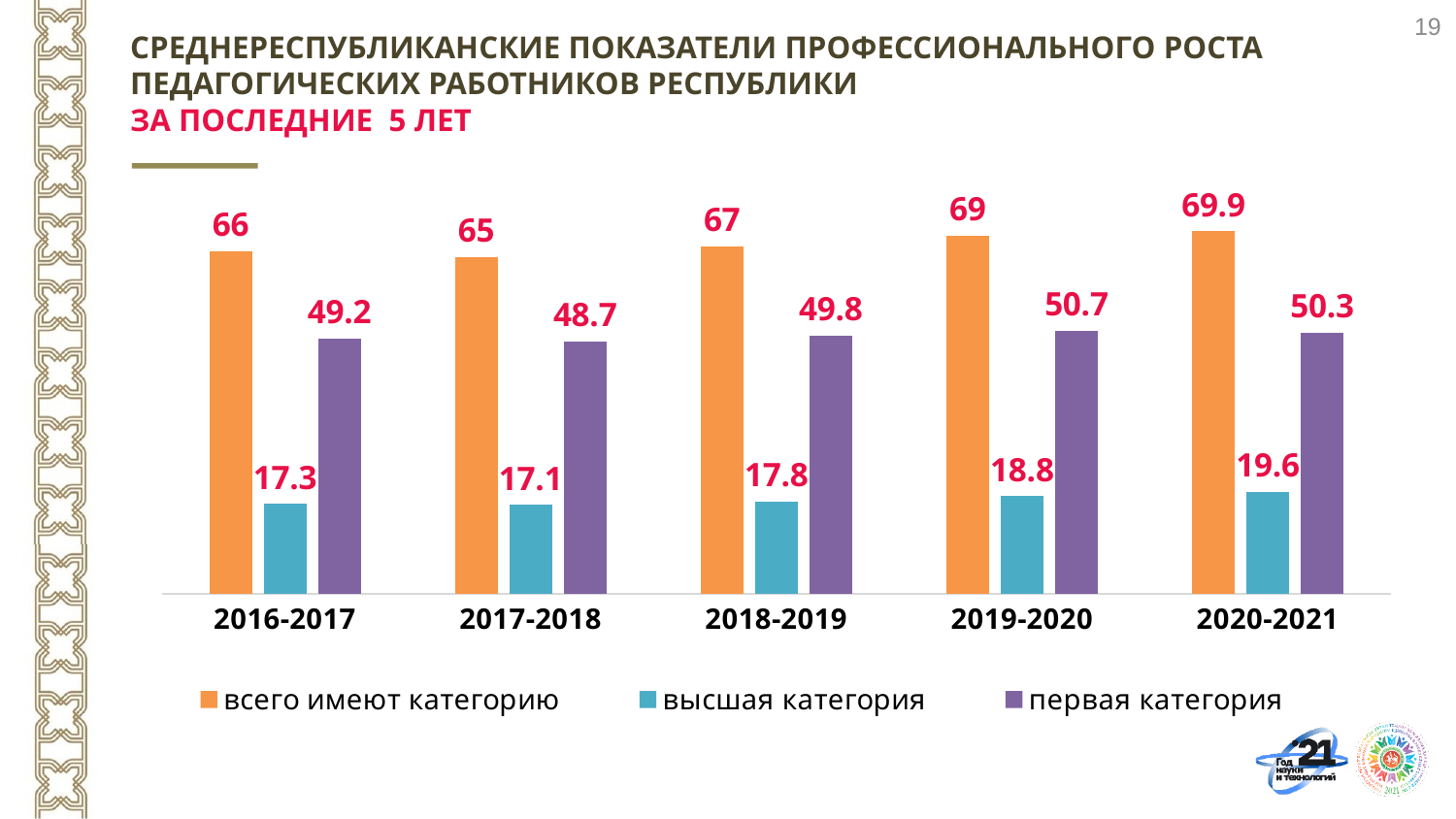
How many year categories are shown on the x axis? 5 Which is larger: "первая категория" in 2019-2020 or in 2020-2021? 2019-2020 What kind of chart is shown on the slide? bar chart What is the value for "высшая категория" in 2019-2020? 18.8 What is the value for "первая категория" in 2017-2018? 48.7 How many series does the legend list? 3 In which year is the value for "всего имеют категорию" highest? 2020-2021 What is the difference between the "всего имеют категорию" values for 2020-2021 and 2016-2017? 3.9 In which year is the value for "высшая категория" lowest? 2017-2018 What is the value for "всего имеют категорию" in 2016-2017? 66 Which colour represents "первая категория" in the legend? purple Does the value for "высшая категория" rise or fall from 2017-2018 to 2020-2021? rise